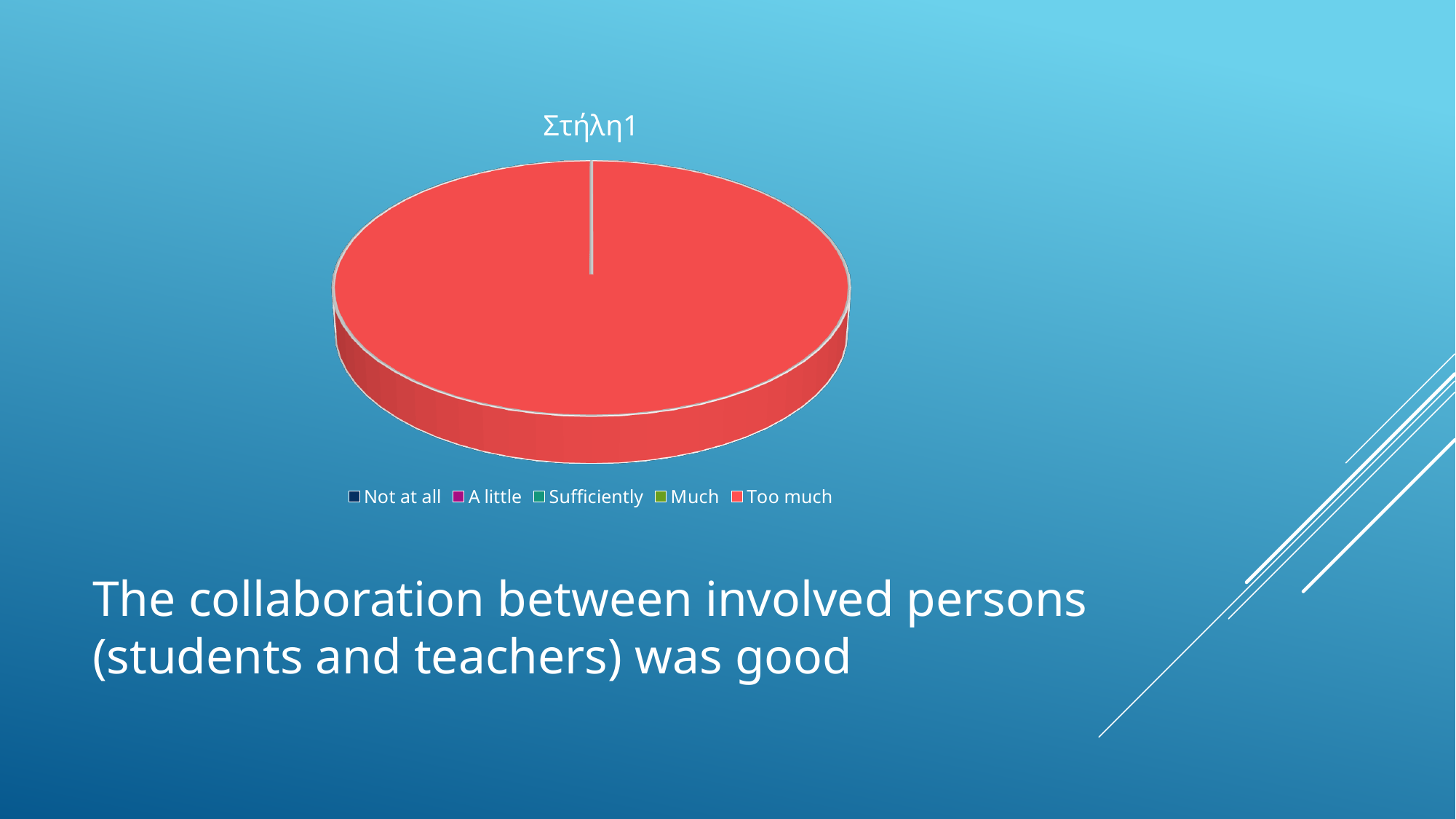
How many categories does the chart's legend list? 5 Which is larger in the pie, the slice for Too much or the slice for Not at all? Too much Which category accounts for the largest share of the pie? Too much Which category is shown in red in the legend? Too much What kind of chart is shown on the slide? pie chart Which category is listed last in the legend? Too much Which category is listed first in the legend? Not at all Which is larger in the pie, the slice for Much or the slice for Too much? Too much